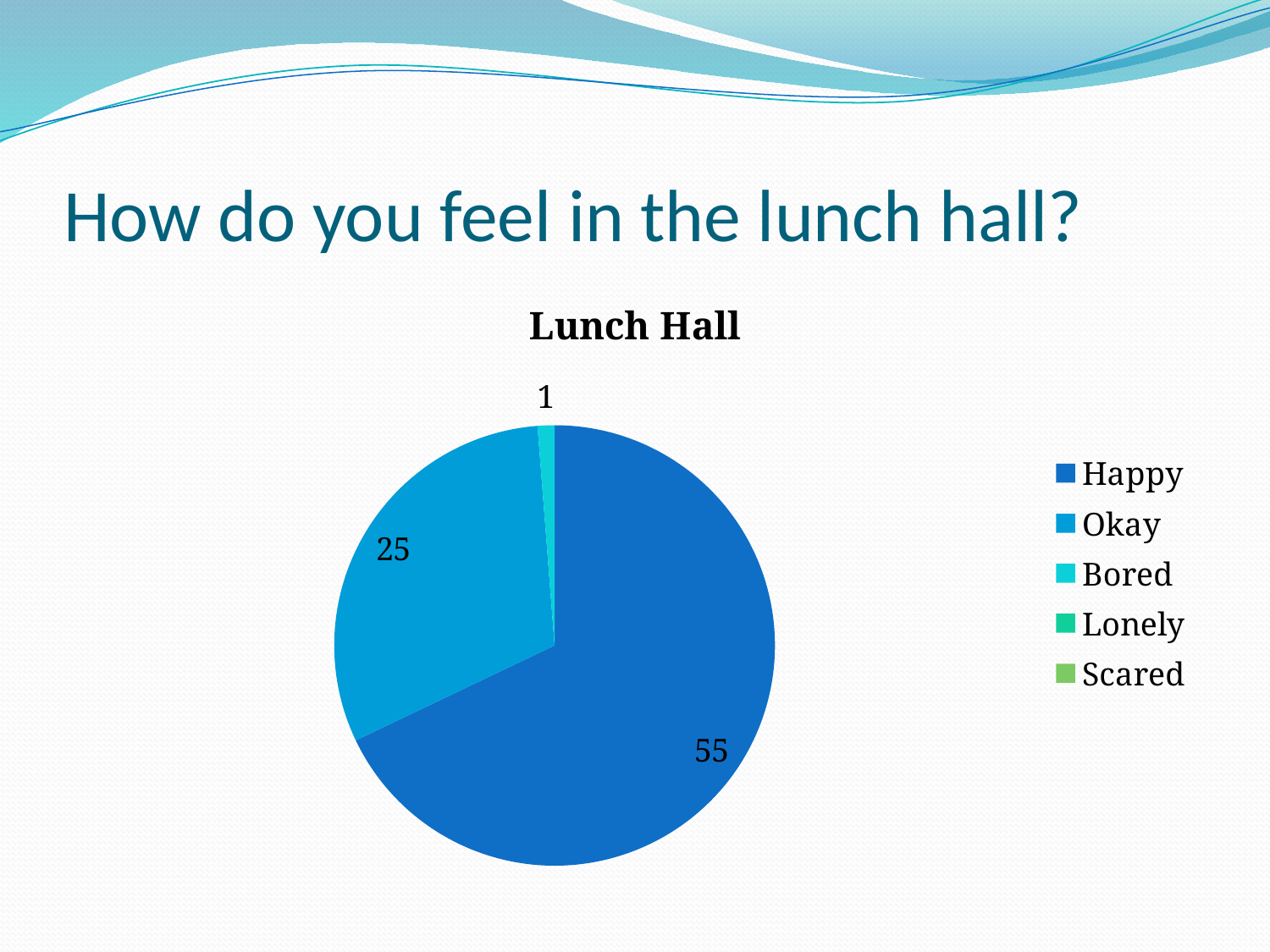
Which category has the largest slice in the Lunch Hall pie chart? Happy Which of the labelled slices is the smallest in the Lunch Hall pie chart? Bored Which legend entry is listed last? Scared What is the value for Bored in the Lunch Hall pie chart? 1 What is the difference between the values for Happy and Okay? 30 What is the value for Happy in the Lunch Hall pie chart? 55 What is the value for Okay in the Lunch Hall pie chart? 25 What is the title of the chart? Lunch Hall Which is larger, the value for Okay or the value for Bored? Okay What is the difference between the values for Okay and Bored? 24 What type of chart is shown on the slide? pie chart How many categories does the legend list? 5